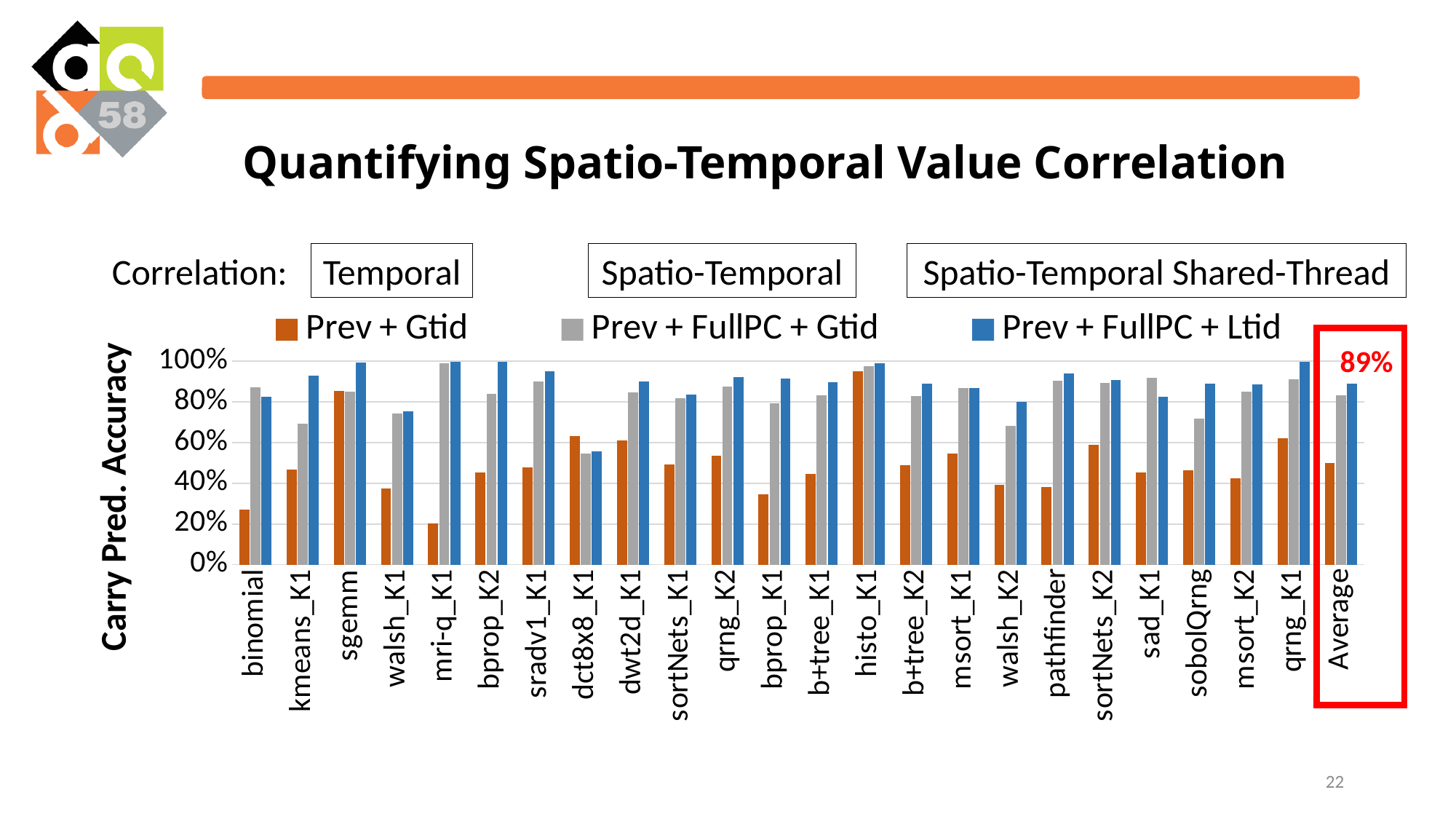
Is the Prev + Gtid value for binomial greater or less than 40%? less Is the Prev + FullPC + Ltid value for dct8x8_K1 greater or less than 60%? less What is the label of the y axis? Carry Pred. Accuracy What is the Prev + FullPC + Ltid value for Average? 89% Is the Prev + Gtid value for sgemm greater or less than 80%? greater Which category has the lowest Prev + Gtid value? mri-q_K1 Which category has the highest Prev + Gtid value? histo_K1 What type of chart is shown on the slide? bar chart Which is larger, the Prev + FullPC + Ltid value for kmeans_K1 or for walsh_K1? kmeans_K1 Which is larger, the Prev + Gtid value for sgemm or for binomial? sgemm How many categories are shown along the x axis? 24 How many series does the legend list? 3